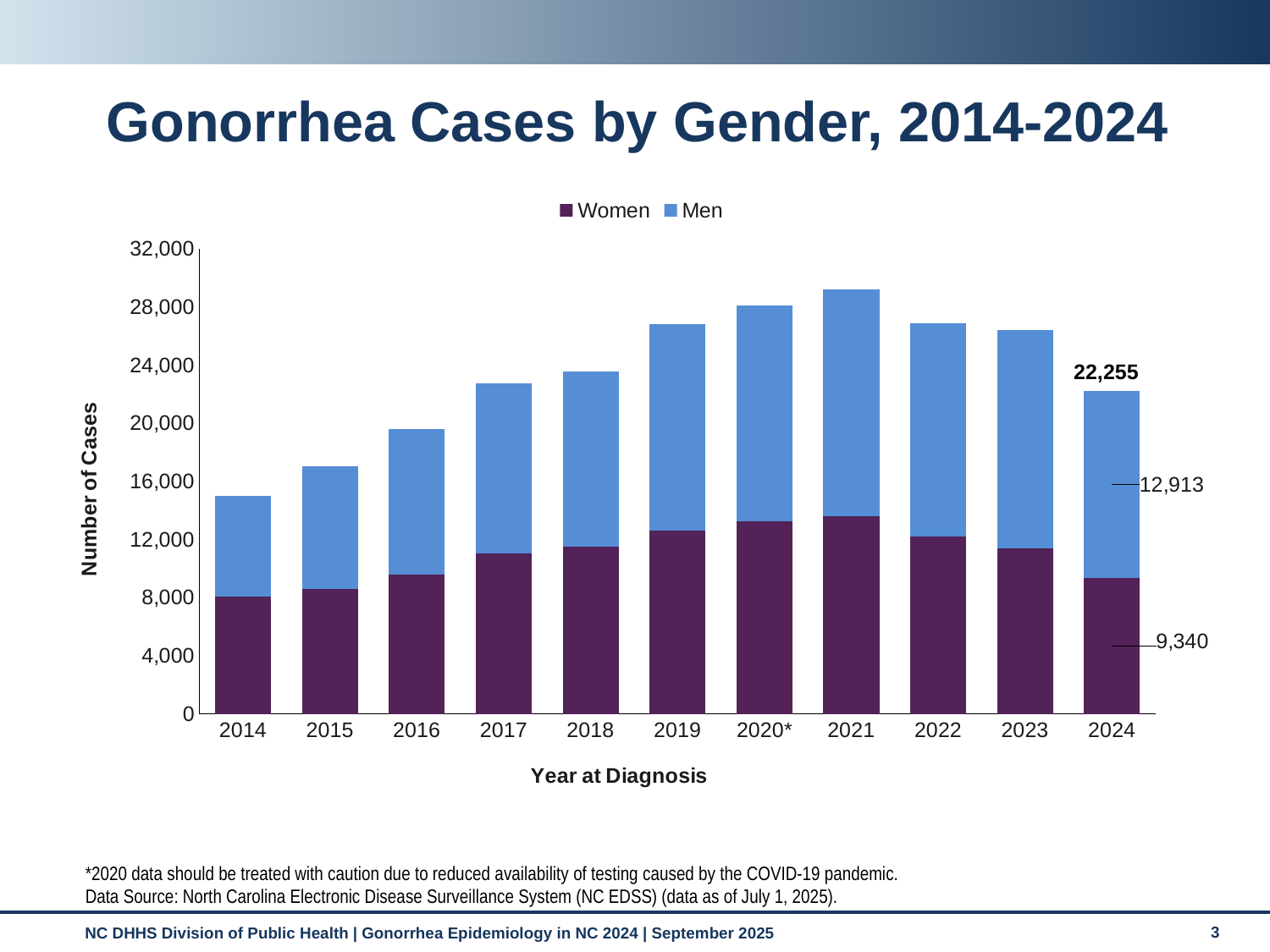
How many years are shown on the x axis? 11 What is the number of gonorrhea cases among women in 2024? 9,340 Which year has the lowest total number of cases? 2014 What is the number of gonorrhea cases among men in 2024? 12,913 How many series does the legend list? 2 Which year has a larger total number of cases, 2018 or 2019? 2019 Which year has the highest total number of cases? 2021 What is the total number of gonorrhea cases in 2024? 22,255 Do the total cases rise or fall from 2021 to 2024? fall In 2024, how many more cases were there among men than among women? 3,573 Is the total number of cases in 2021 greater or less than 28,000? greater Is the total number of cases in 2014 greater or less than 16,000? less